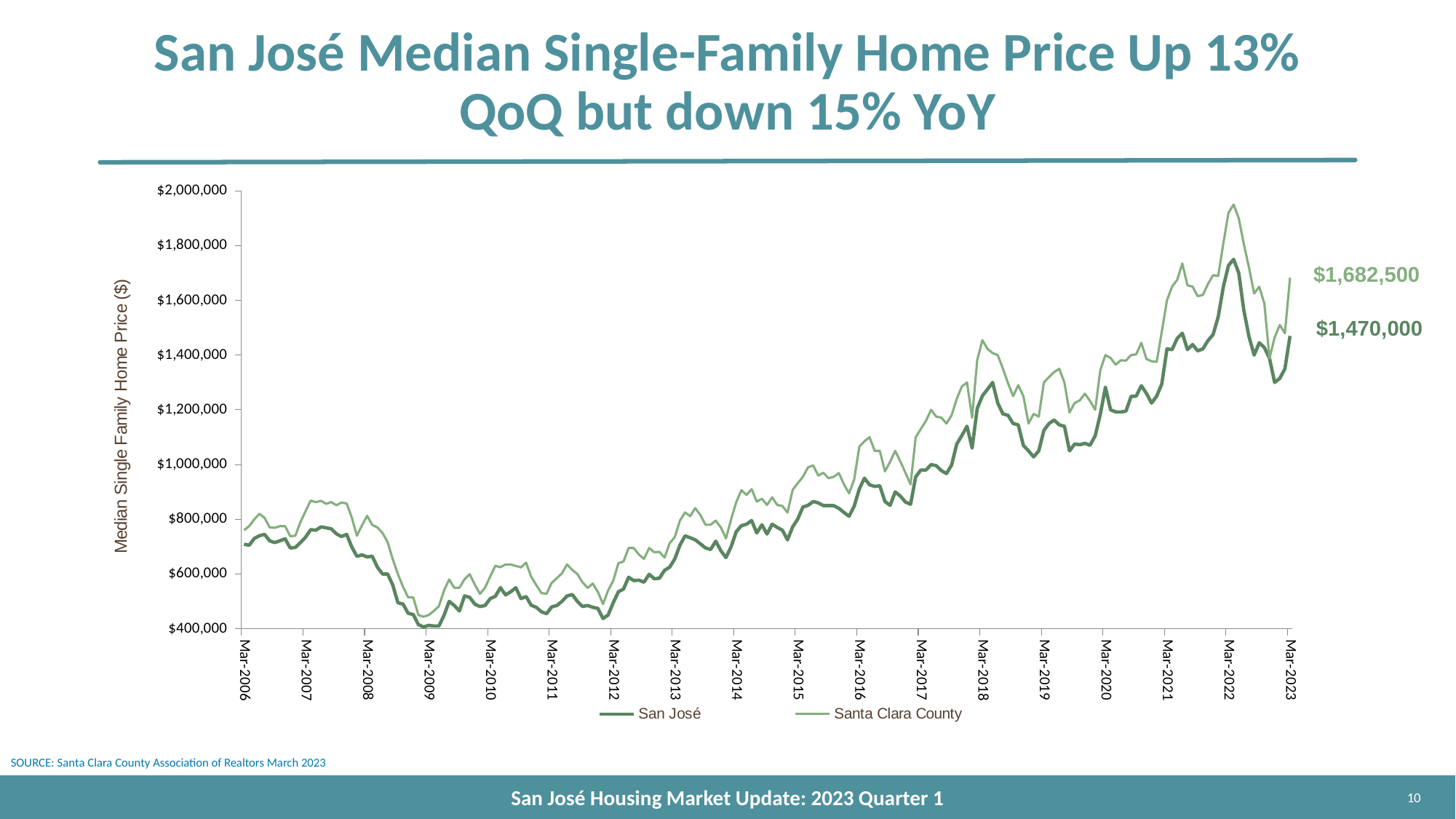
How many year labels are shown on the x axis? 18 Overall, do the median home prices rise or fall from Mar-2006 to Mar-2023? rise What is the title of the vertical axis? Median Single Family Home Price ($) What is the difference between the Santa Clara County and San José values labelled at Mar-2023? $212,500 Is the San José value at Mar-2006 greater or less than $800,000? less Is the Santa Clara County value at Mar-2018 greater or less than $1,200,000? greater Which series has the higher value at Mar-2023, San José or Santa Clara County? Santa Clara County What is the San José median single-family home price labelled at Mar-2023? $1,470,000 What kind of chart is shown on the slide? line chart How many series does the legend list? 2 Is the San José value at Mar-2009 greater or less than $600,000? less What is the Santa Clara County median single-family home price labelled at Mar-2023? $1,682,500